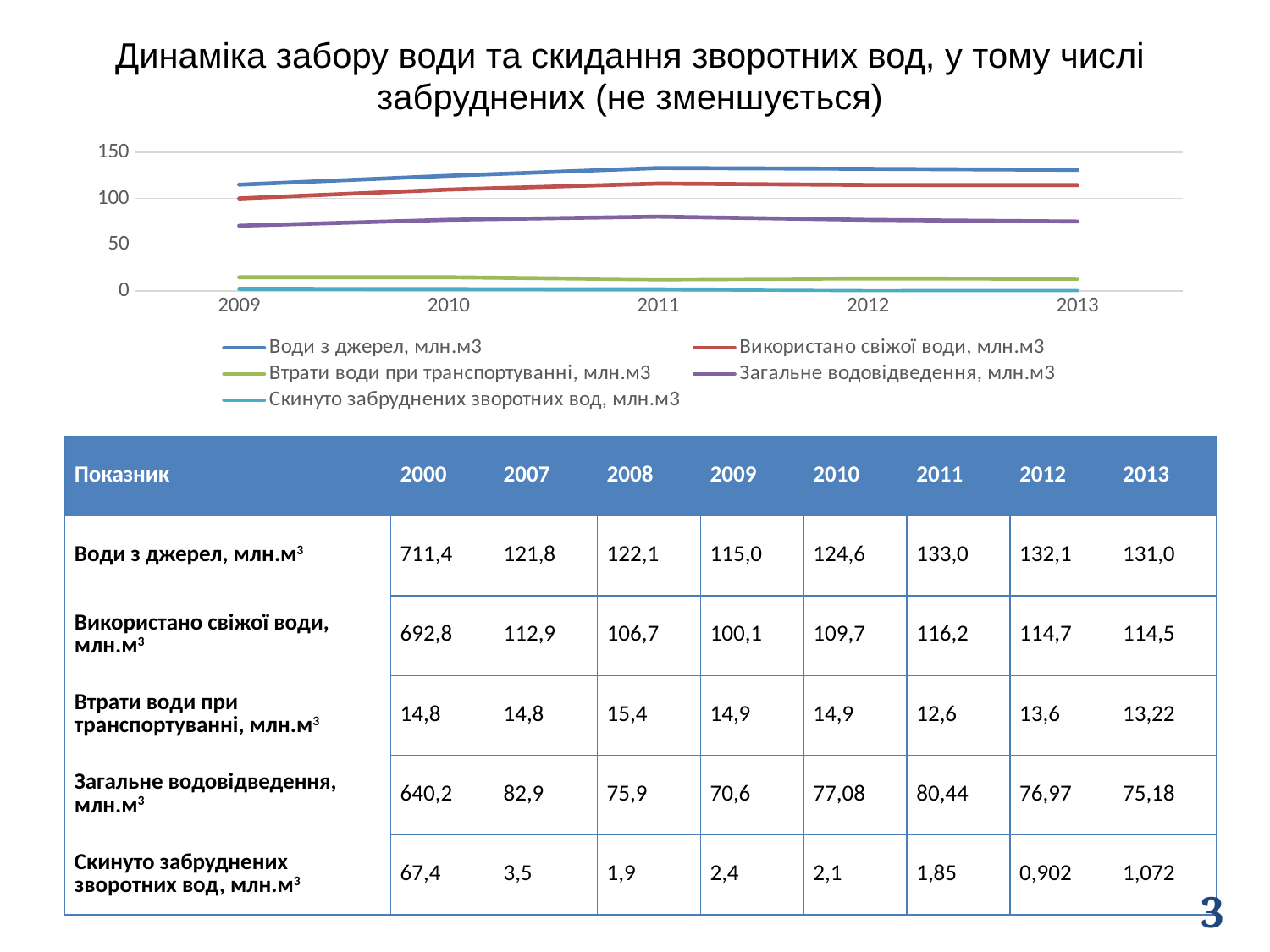
Is the value for 'Води з джерел, млн.м3' in 2009 greater or less than 100? greater In 2010, which is larger: 'Використано свіжої води, млн.м3' or 'Загальне водовідведення, млн.м3'? Використано свіжої води, млн.м3 How many series does the chart legend list? 5 What is the value of 'Води з джерел, млн.м3' in 2011? 133,0 Is the value for 'Загальне водовідведення, млн.м3' in 2011 greater or less than 100? less In which plotted year is 'Загальне водовідведення, млн.м3' highest? 2011 How many years are plotted along the x axis of the chart? 5 In which plotted year is 'Використано свіжої води, млн.м3' lowest? 2009 Does 'Використано свіжої води, млн.м3' rise or fall from 2009 to 2011? rise What kind of chart is shown on the slide? line chart What is the difference between 'Води з джерел, млн.м3' and 'Використано свіжої води, млн.м3' in 2013? 16,5 What is the value of 'Скинуто забруднених зворотних вод, млн.м3' in 2013? 1,072